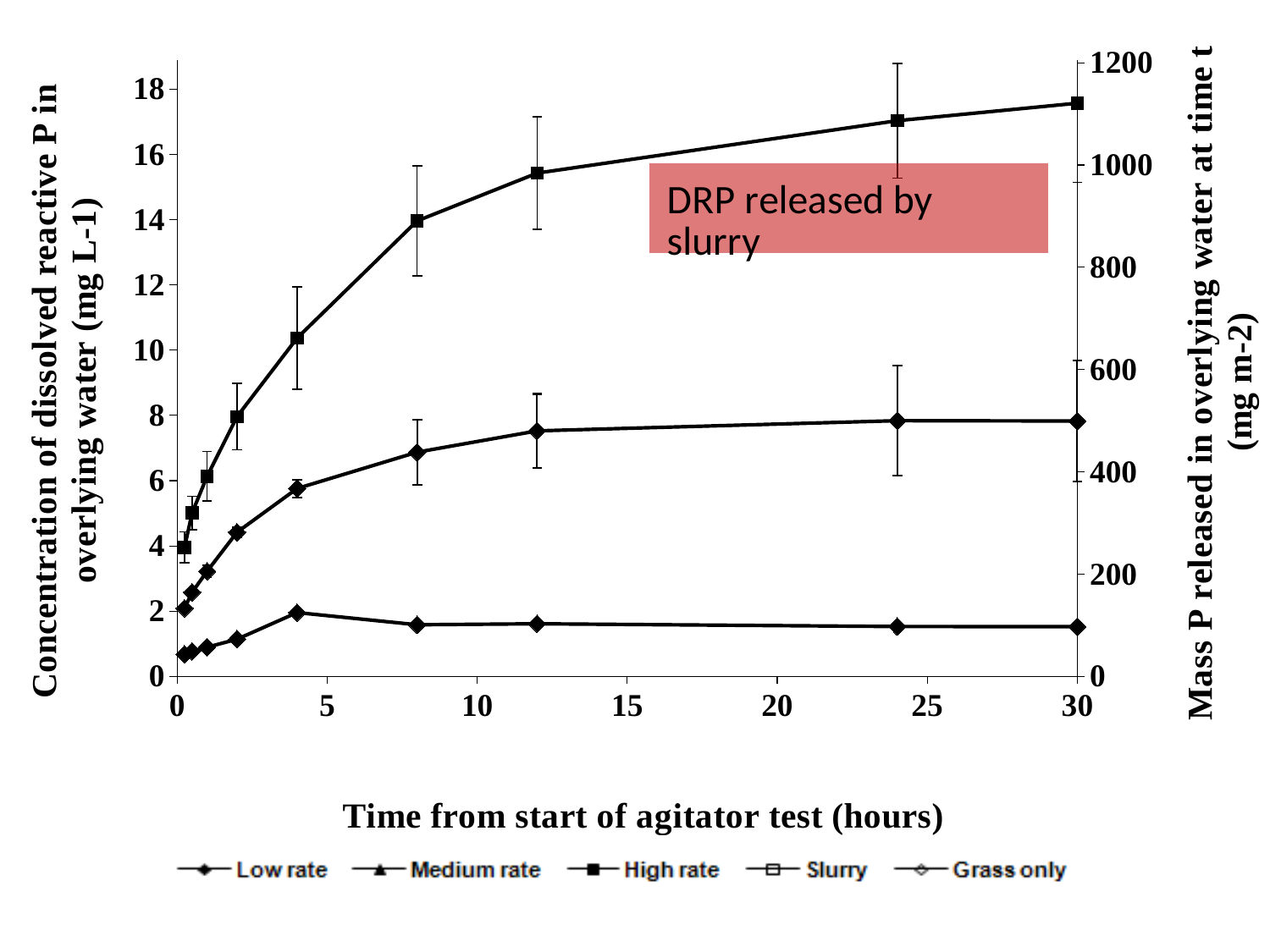
Is the value of the High rate series (square markers) at 30 hours greater or less than 16 on the left axis? greater Which of the three plotted lines has the highest value at 24 hours? High rate (square markers) What text is written in the red box on the chart? DRP released by slurry What is the title of the x axis? Time from start of agitator test (hours) What kind of chart is shown on the slide? line chart Does the High rate series (square markers) rise or fall as time increases along the x axis? rise Is the value of the lowest line at 30 hours greater or less than 2 on the left axis? less Is the value of the middle line at 30 hours greater or less than 6 on the left axis? greater At 30 hours, which is larger: the High rate series (square markers) or the lowest line? High rate What is the maximum value shown on the right-hand y axis? 1200 How many series does the legend list? 5